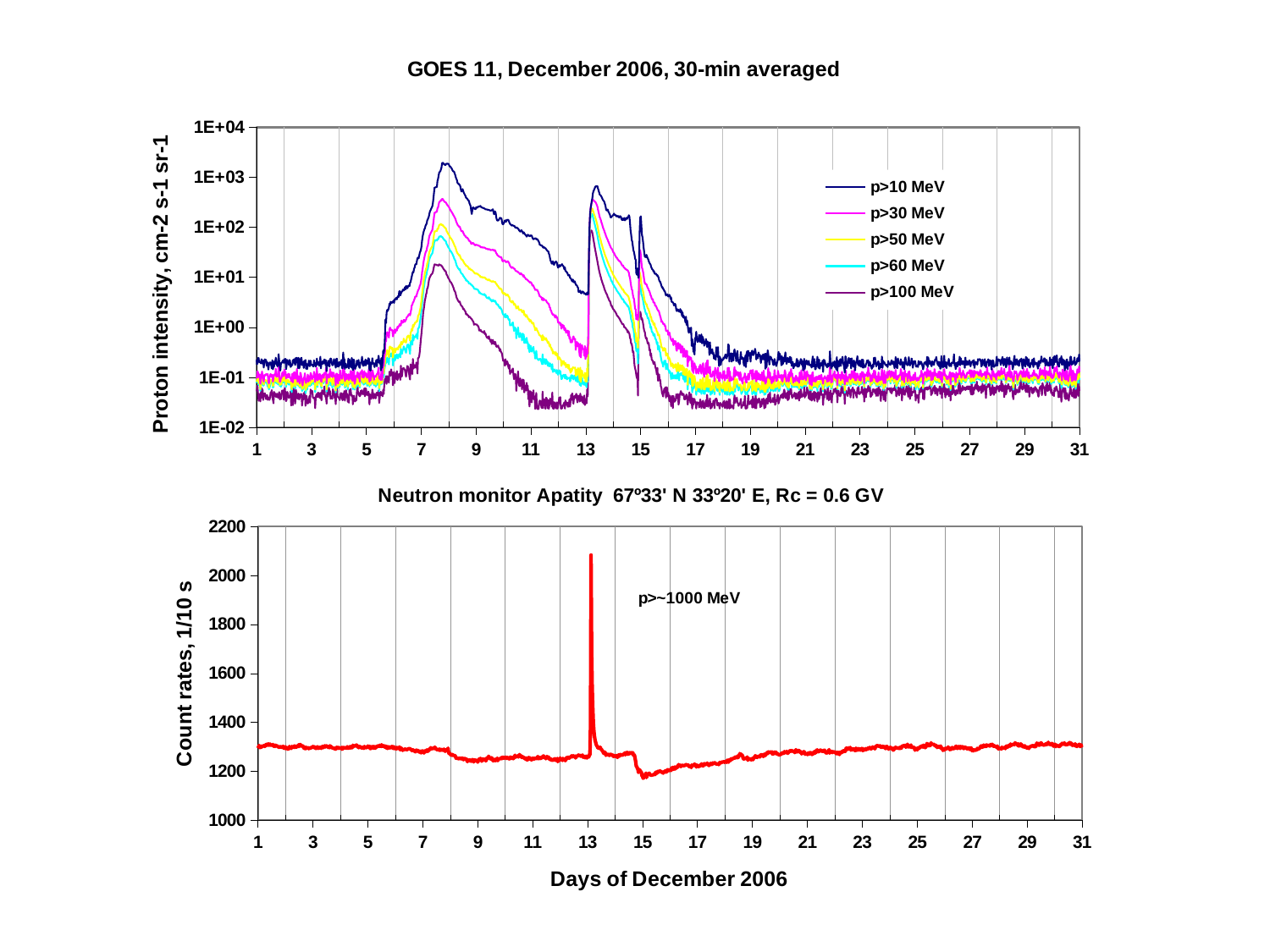
What kind of chart is the top chart titled 'GOES 11, December 2006, 30-min averaged'? line chart In the top chart (GOES 11), is the peak value of the p>100 MeV series around day 8 greater or less than 1E+02? less In the bottom chart (Neutron monitor Apatity), is the peak count rate around day 13 greater or less than 2000? greater In the top chart (GOES 11), which series has the highest proton intensity throughout the month? p>10 MeV How many series does the legend of the top chart (GOES 11) list? 5 In the top chart (GOES 11), which series has the lowest proton intensity throughout the month? p>100 MeV What is the x-axis title of the bottom chart (Neutron monitor Apatity)? Days of December 2006 In the bottom chart (Neutron monitor Apatity), do the count rates rise or fall from day 15 to day 31? rise In the top chart (GOES 11), which is larger around day 8: the p>10 MeV series or the p>100 MeV series? p>10 MeV In the bottom chart (Neutron monitor Apatity), is the count rate on day 1 greater or less than 1200? greater In the top chart (GOES 11), which series is drawn in yellow? p>50 MeV